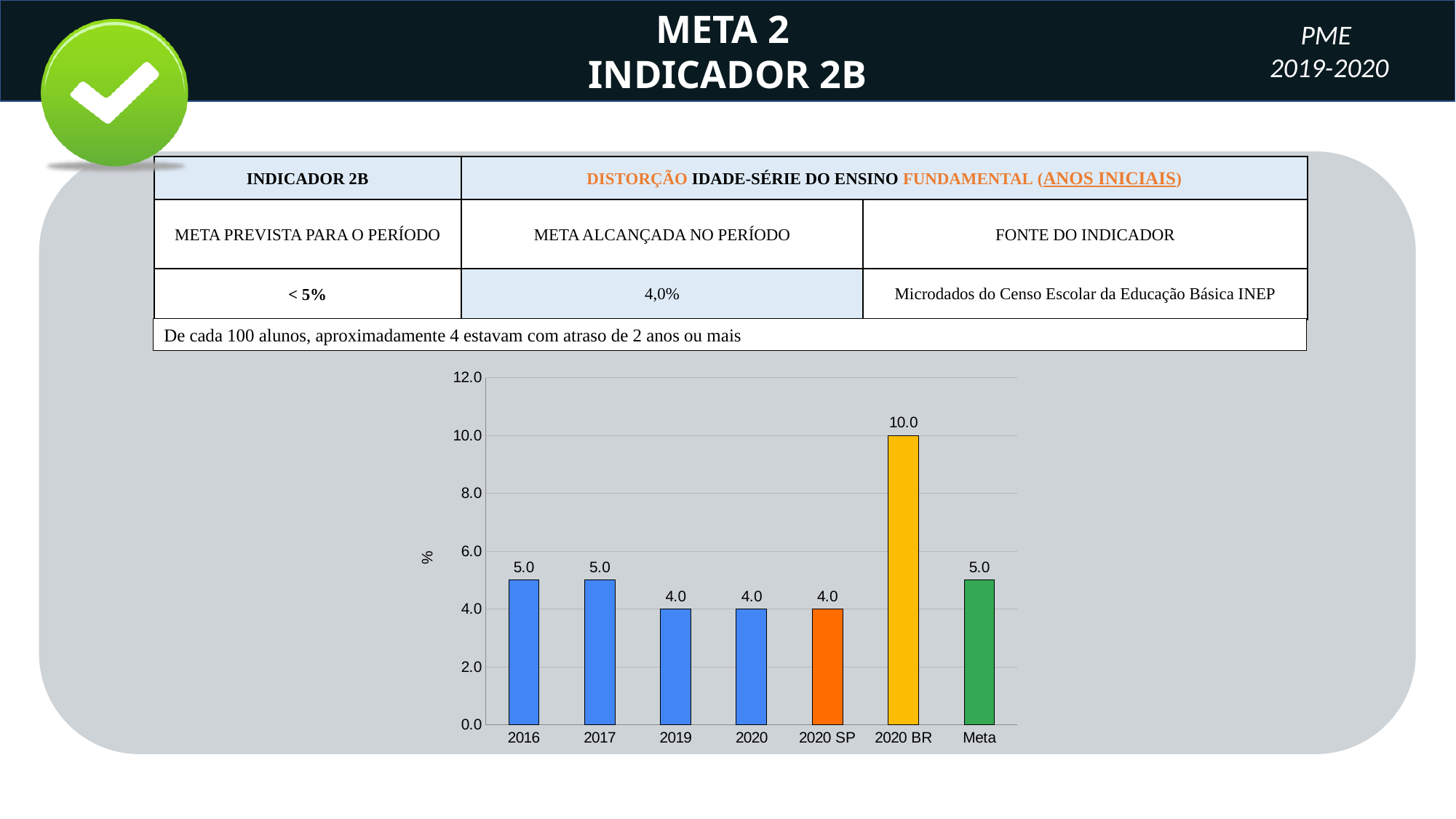
What is the label on the vertical axis of the chart? % Which is larger, the value for 2016 or the value for 2020? 2016 What is the difference between the values for 2020 BR and 2020 SP? 6.0 How many categories are shown on the x axis of the chart? 7 Which category has the highest value in the chart? 2020 BR What is the value for 2016 in the chart? 5.0 What is the value for Meta in the chart? 5.0 Is the value for 2020 BR greater or less than 8.0? greater What is the value for 2020 SP in the chart? 4.0 What is the value for 2020 BR in the chart? 10.0 What is the difference between the values for 2017 and 2019? 1.0 What kind of chart is shown on the slide? bar chart